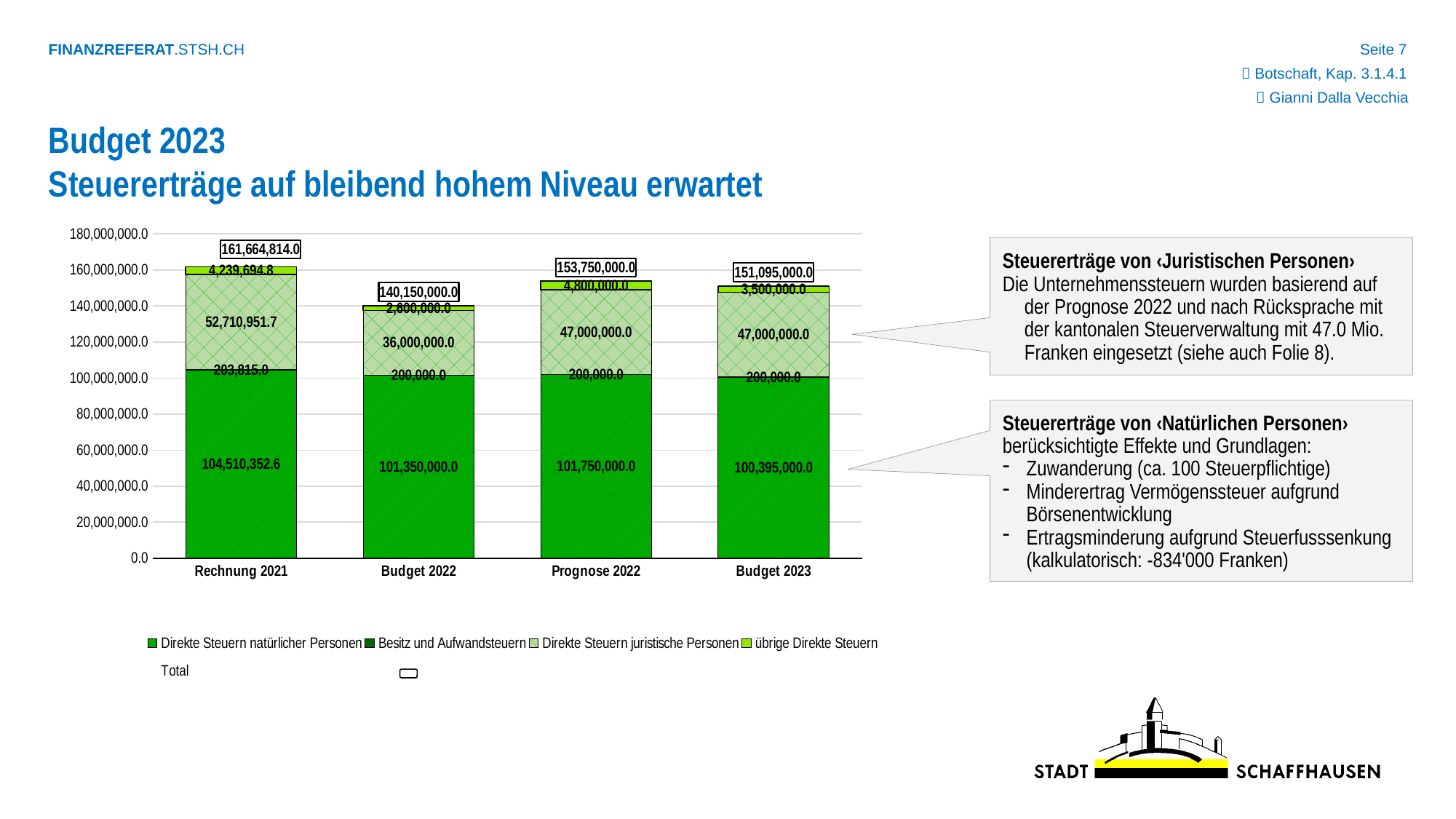
What is the total of the stacked bar for Budget 2023? 151,095,000.0 Which category has the highest total? Rechnung 2021 Is the total for Budget 2022 greater or less than 160,000,000.0? less How many categories are shown on the x axis? 4 What is the value of Direkte Steuern juristische Personen for Budget 2022? 36,000,000.0 What is the difference between the totals for Prognose 2022 and Budget 2023? 2,655,000.0 What is the value of übrige Direkte Steuern for Rechnung 2021? 4,239,694.8 Which is larger for Direkte Steuern natürlicher Personen: Prognose 2022 or Budget 2022? Prognose 2022 What is the value of Besitz und Aufwandsteuern for Rechnung 2021? 203,815.0 What is the difference in Direkte Steuern juristische Personen between Rechnung 2021 and Budget 2022? 16,710,951.7 What kind of chart is shown on the slide? Stacked bar chart Which category has the lowest total? Budget 2022